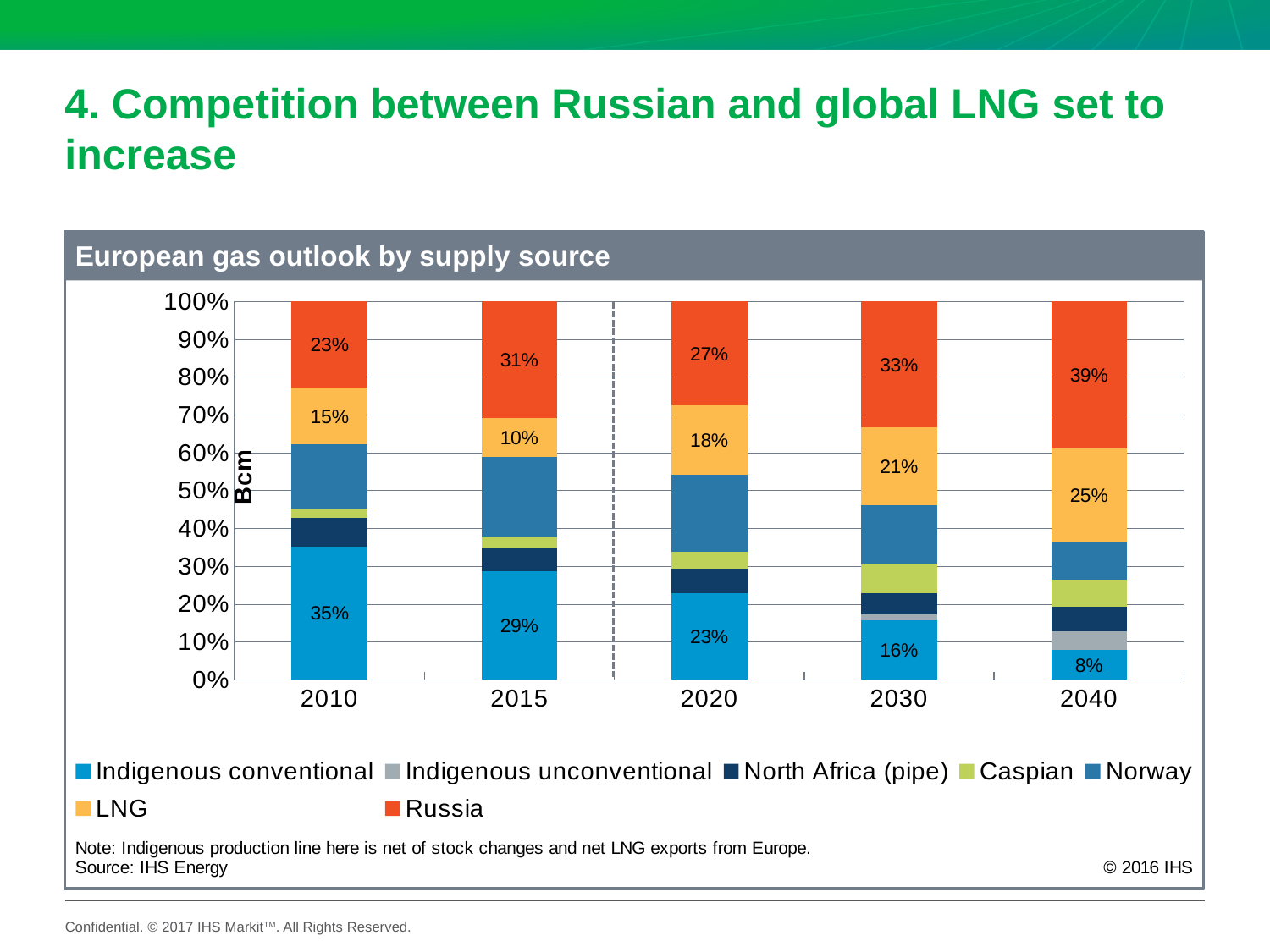
What is the title of the chart? European gas outlook by supply source How many supply sources does the legend list? 7 Does the Indigenous conventional share rise or fall from 2010 to 2040? Fall In which year is the Russia share the highest? 2040 What kind of chart is this? Stacked bar chart What is the Indigenous conventional share in 2015? 29% What is the LNG share in 2020? 18% What share does Russia account for in 2040? 39% By how many percentage points does the Russia share in 2040 exceed the Russia share in 2010? 16 percentage points In which year is the Indigenous conventional share the lowest? 2040 Which is larger in 2030: the LNG share or the Indigenous conventional share? LNG share How many years are shown on the x axis? 5